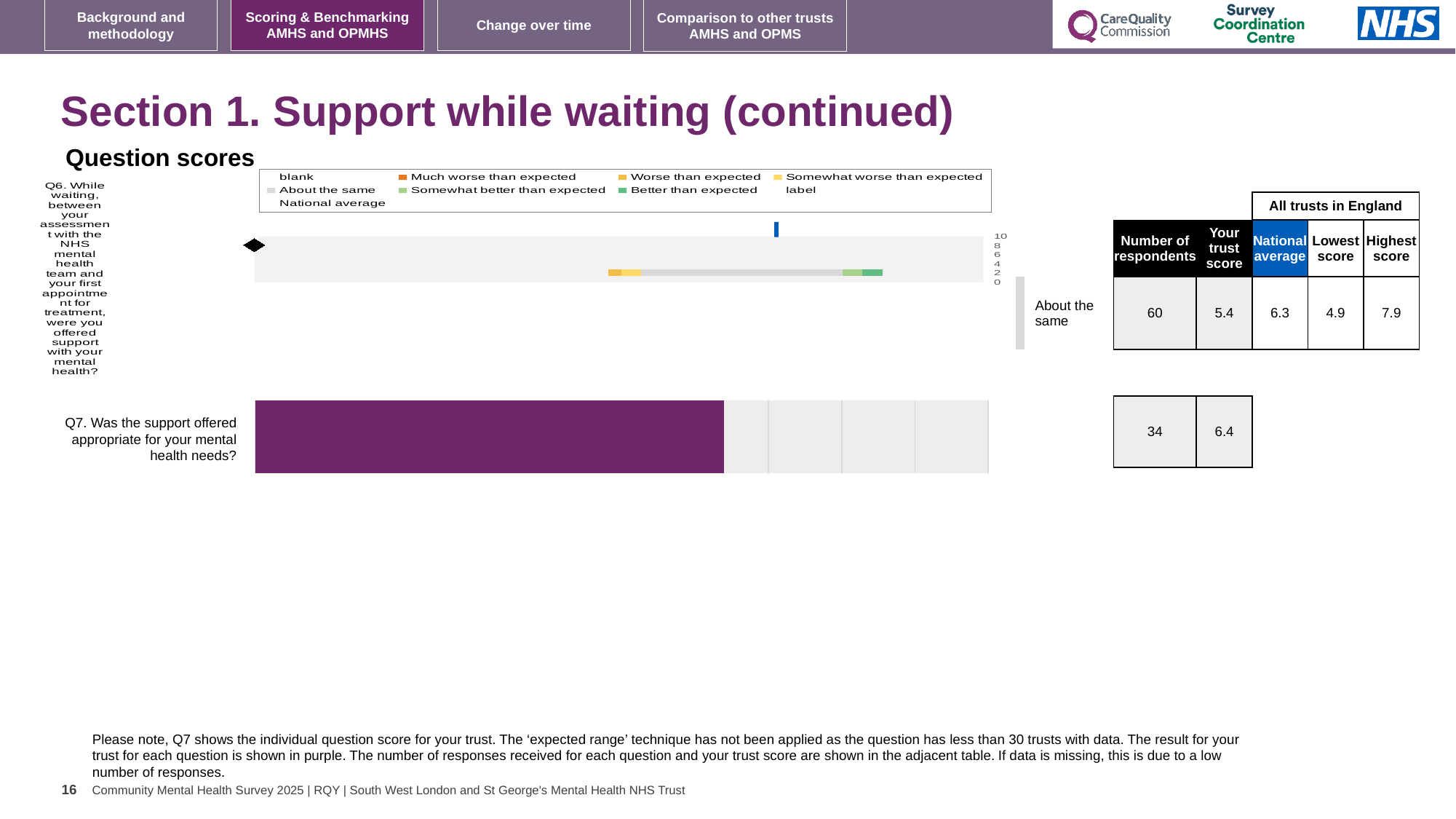
How many respondents answered Q7? 34 How is the trust's Q6 result categorised relative to the expected range? About the same What is the highest score among all trusts in England for Q6? 7.9 Is the Q7 trust score bar greater or less than 8 on the 0-10 scale? less Which is larger for Q6: the trust score or the national average? National average What is the difference between the national average and the trust score for Q6? 0.9 What is the national average score for Q6? 6.3 How many respondents answered Q6? 60 What is the trust score for Q6 (support while waiting between assessment and first appointment)? 5.4 What is the lowest score among all trusts in England for Q6? 4.9 What is the trust score for Q7 (was the support offered appropriate for your mental health needs)? 6.4 What colour is the bar showing the trust's Q7 score? Purple